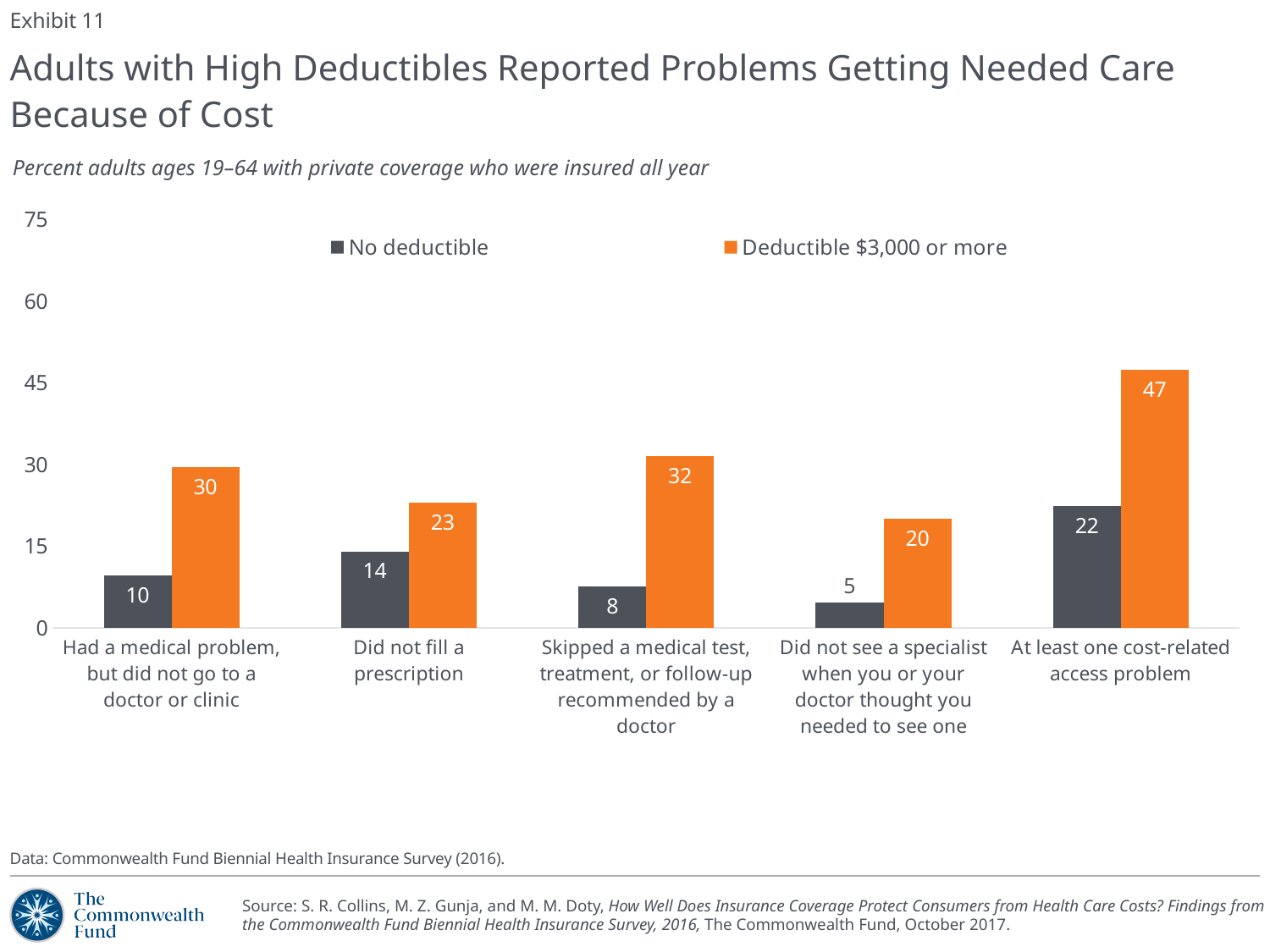
What is the value for "Deductible $3,000 or more" for "Did not fill a prescription"? 23 Which colour represents the "Deductible $3,000 or more" series? Orange Which category has the lowest value for "No deductible"? Did not see a specialist when you or your doctor thought you needed to see one Which is larger: the "Deductible $3,000 or more" value for "Skipped a medical test, treatment, or follow-up recommended by a doctor" or for "Did not see a specialist when you or your doctor thought you needed to see one"? Skipped a medical test, treatment, or follow-up recommended by a doctor How many series does the legend list? 2 What is the value for "No deductible" for "At least one cost-related access problem"? 22 Which category has the highest value for "Deductible $3,000 or more"? At least one cost-related access problem What kind of chart is shown on the slide? Bar chart What is the difference between the "Deductible $3,000 or more" and "No deductible" values for "Had a medical problem, but did not go to a doctor or clinic"? 20 How many categories are shown on the x axis? 5 What is the value for "No deductible" for "Skipped a medical test, treatment, or follow-up recommended by a doctor"? 8 Is the value for "Deductible $3,000 or more" for "At least one cost-related access problem" greater or less than 45? greater